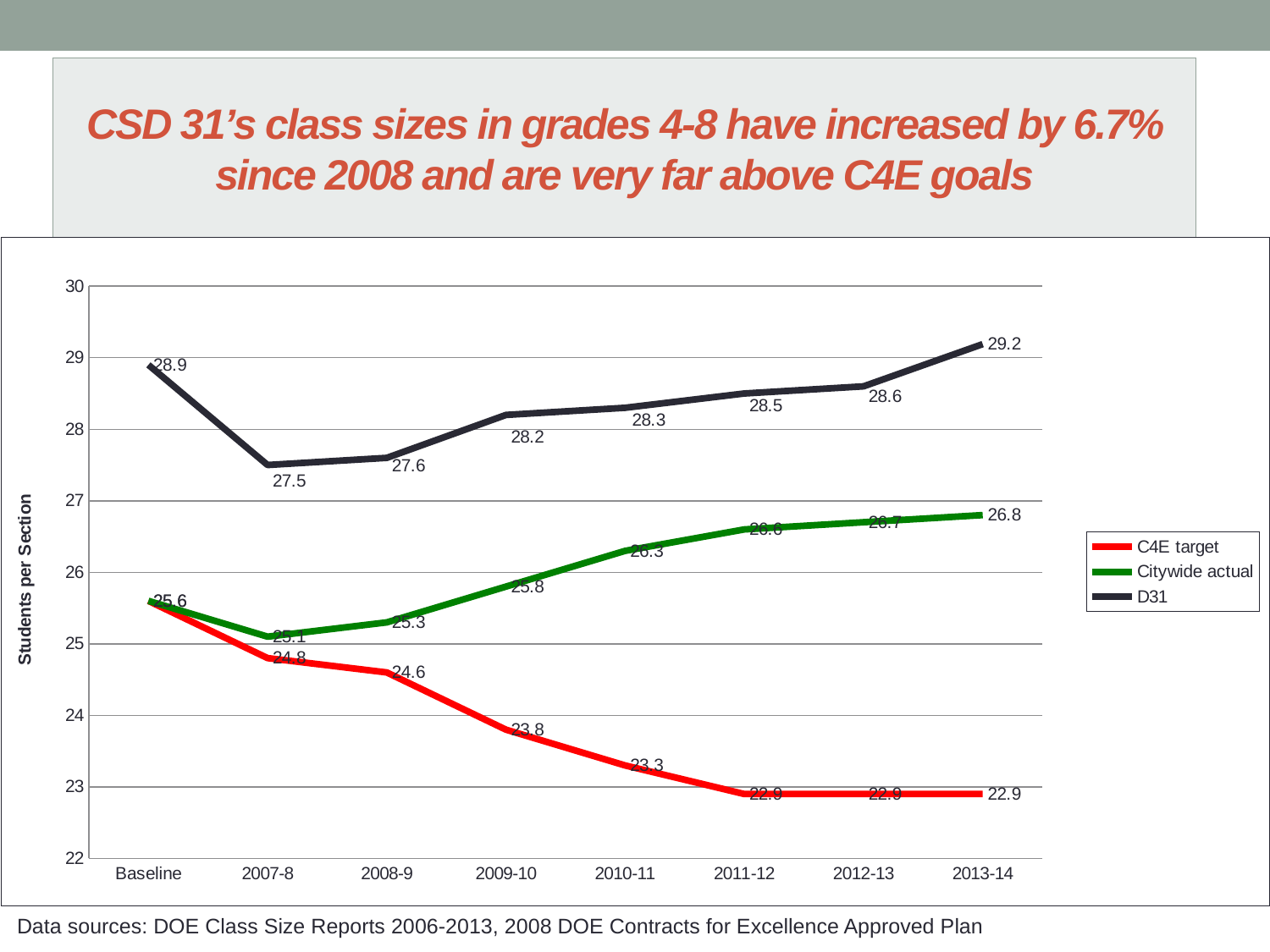
What type of chart is shown on the slide? line chart How many series does the legend list? 3 What is the D31 value for 2013-14? 29.2 In which year is the D31 series at its highest? 2013-14 What is the Citywide actual value for 2010-11? 26.3 Which is larger in 2008-9, the D31 value or the Citywide actual value? D31 How many categories are shown on the x axis? 8 What is the C4E target value for 2009-10? 23.8 What is the D31 value for 2007-8? 27.5 What is the difference between the D31 value and the C4E target value in 2013-14? 6.3 In which year is the D31 series at its lowest? 2007-8 Does the C4E target series rise or fall from Baseline to 2011-12? fall